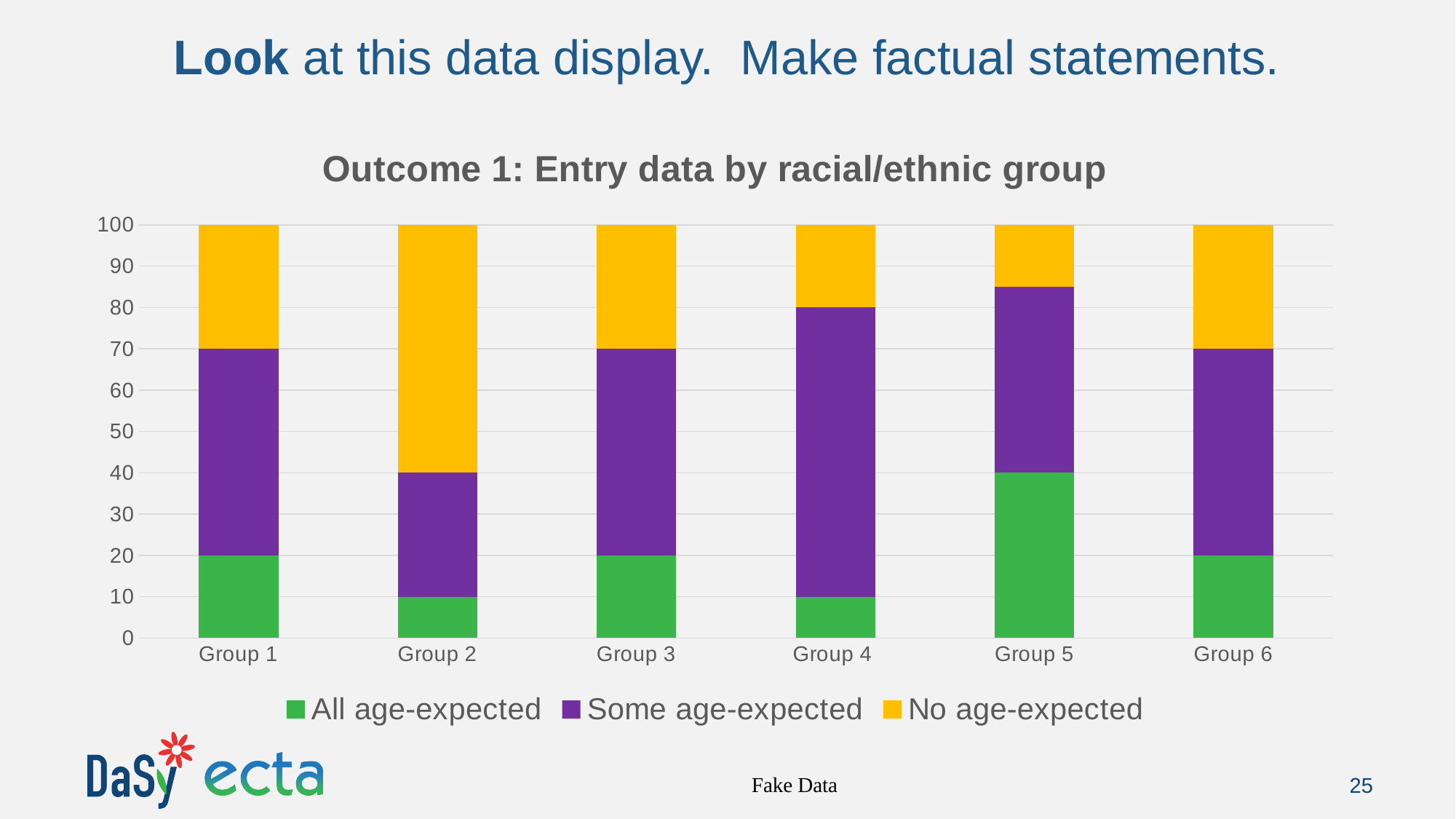
Which group has the highest All age-expected value? Group 5 What is the value of All age-expected for Group 1? 20 How many groups are shown on the x axis of the chart? 6 What is the difference between the All age-expected values for Group 5 and Group 1? 20 What type of chart is shown on the slide? Stacked bar chart What is the value of All age-expected for Group 5? 40 Which group has the largest Some age-expected segment? Group 4 How many series does the legend list? 3 Which group has the highest No age-expected value? Group 2 Is the No age-expected value for Group 2 greater or less than 50? greater What is the total of the stacked bar for Group 3? 100 What is the value of All age-expected for Group 2? 10